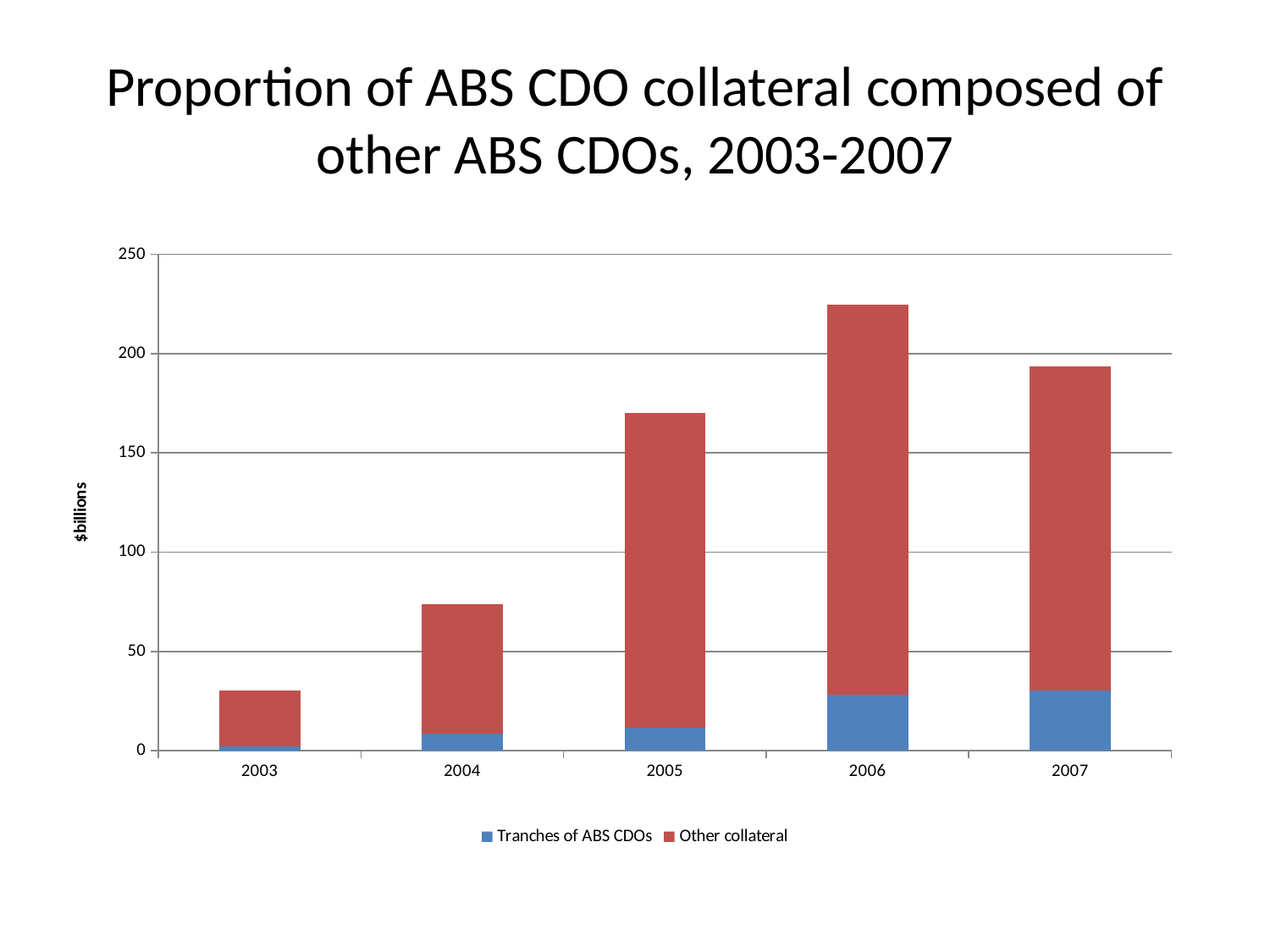
Which year has the tallest total bar? 2006 How many years are shown on the x axis of the chart? 5 What kind of chart is shown on the slide? Stacked bar chart Is the total bar for 2004 greater or less than 100? less Is the total bar for 2007 greater or less than 200? less Is the total bar for 2005 greater or less than 150? greater Do the total bars rise or fall from 2003 to 2006? rise How many series does the chart's legend list? 2 Which is larger, the total bar for 2005 or the total bar for 2007? 2007 What is the label on the vertical axis of the chart? $billions Which year has the shortest total bar? 2003